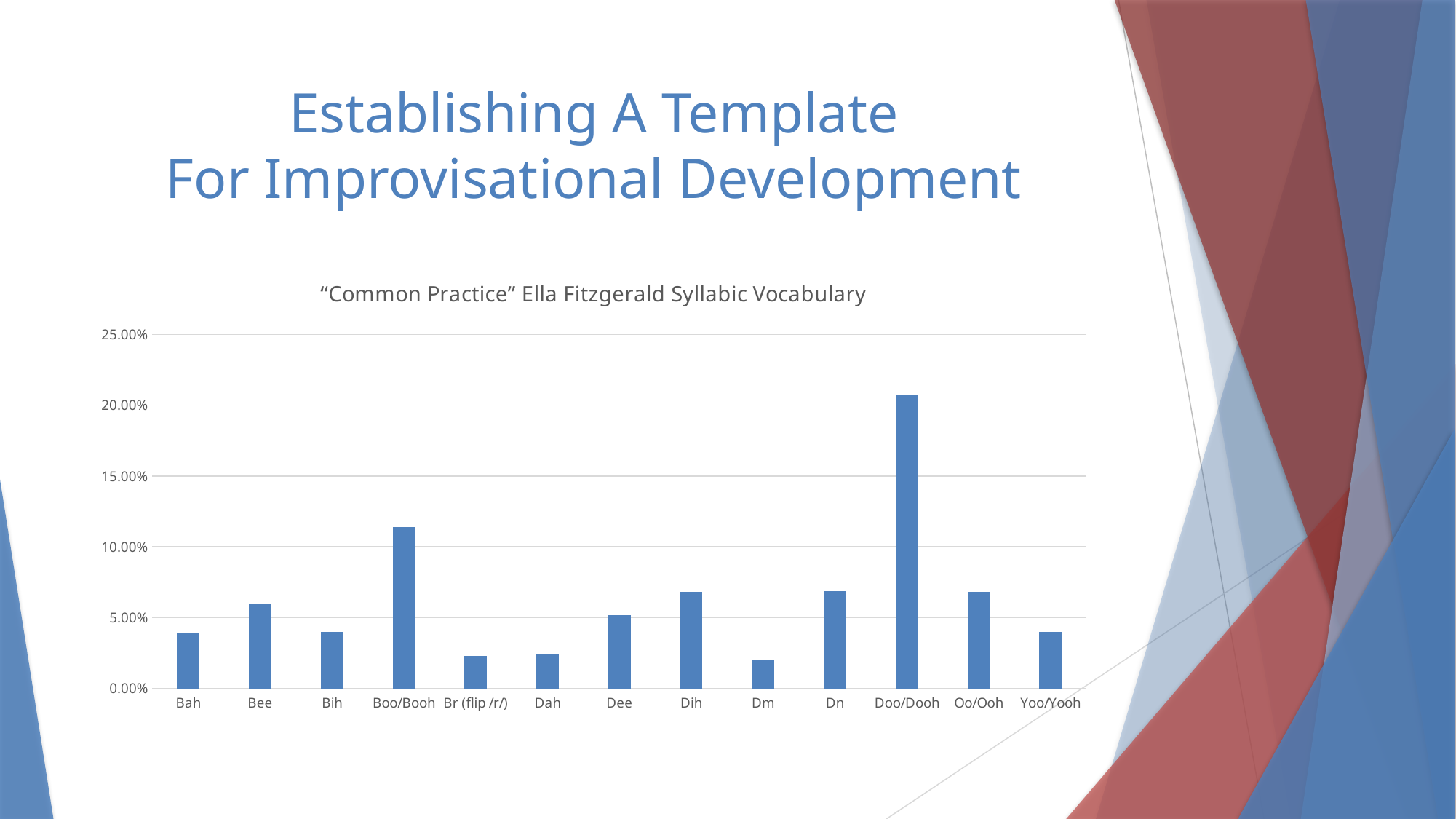
Is the value for Doo/Dooh greater or less than 20.00%? greater Which has a larger value, Boo/Booh or Bee? Boo/Booh Which syllable has the highest value? Doo/Dooh Is the value for Bah greater or less than 5.00%? less What kind of chart is shown on the slide? Bar chart Is the value for Dm greater or less than 5.00%? less How many syllable categories are plotted on the x axis? 13 What is the title of the chart? "Common Practice" Ella Fitzgerald Syllabic Vocabulary Which has a larger value, Bee or Bah? Bee Which has a larger value, Dih or Dm? Dih